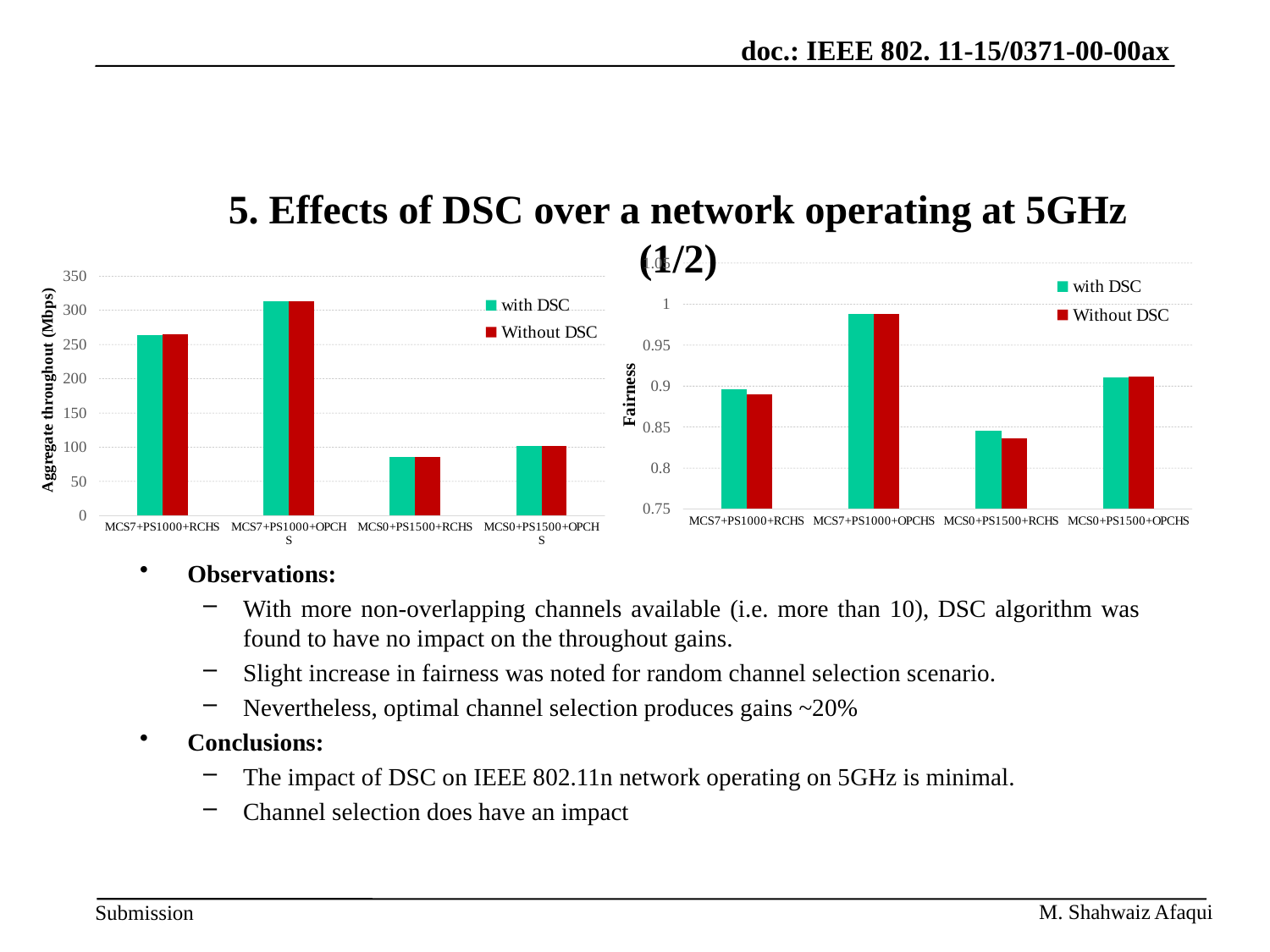
What kind of chart is the left chart (Aggregate throughout)? bar chart In the left chart (Aggregate throughout), which category has the highest throughput? MCS7+PS1000+OPCHS In the left chart (Aggregate throughout), which category has the lowest throughput? MCS0+PS1500+RCHS In the left chart (Aggregate throughout), which is larger: the 'with DSC' value for MCS7+PS1000+RCHS or for MCS0+PS1500+OPCHS? MCS7+PS1000+RCHS What is the y-axis title of the left chart? Aggregate throughout (Mbps) In the right chart (Fairness), which category has the lowest fairness? MCS0+PS1500+RCHS How many series does the legend of the right chart (Fairness) list? 2 In the left chart (Aggregate throughout), is the 'with DSC' value for MCS0+PS1500+RCHS greater or less than 100? less In the right chart (Fairness), which category has the highest fairness? MCS7+PS1000+OPCHS How many categories are shown on the x axis of the left chart (Aggregate throughout)? 4 In the right chart (Fairness), is the 'with DSC' value for MCS0+PS1500+OPCHS greater or less than 0.9? greater In the left chart (Aggregate throughout), is the 'with DSC' value for MCS7+PS1000+OPCHS greater or less than 300? greater